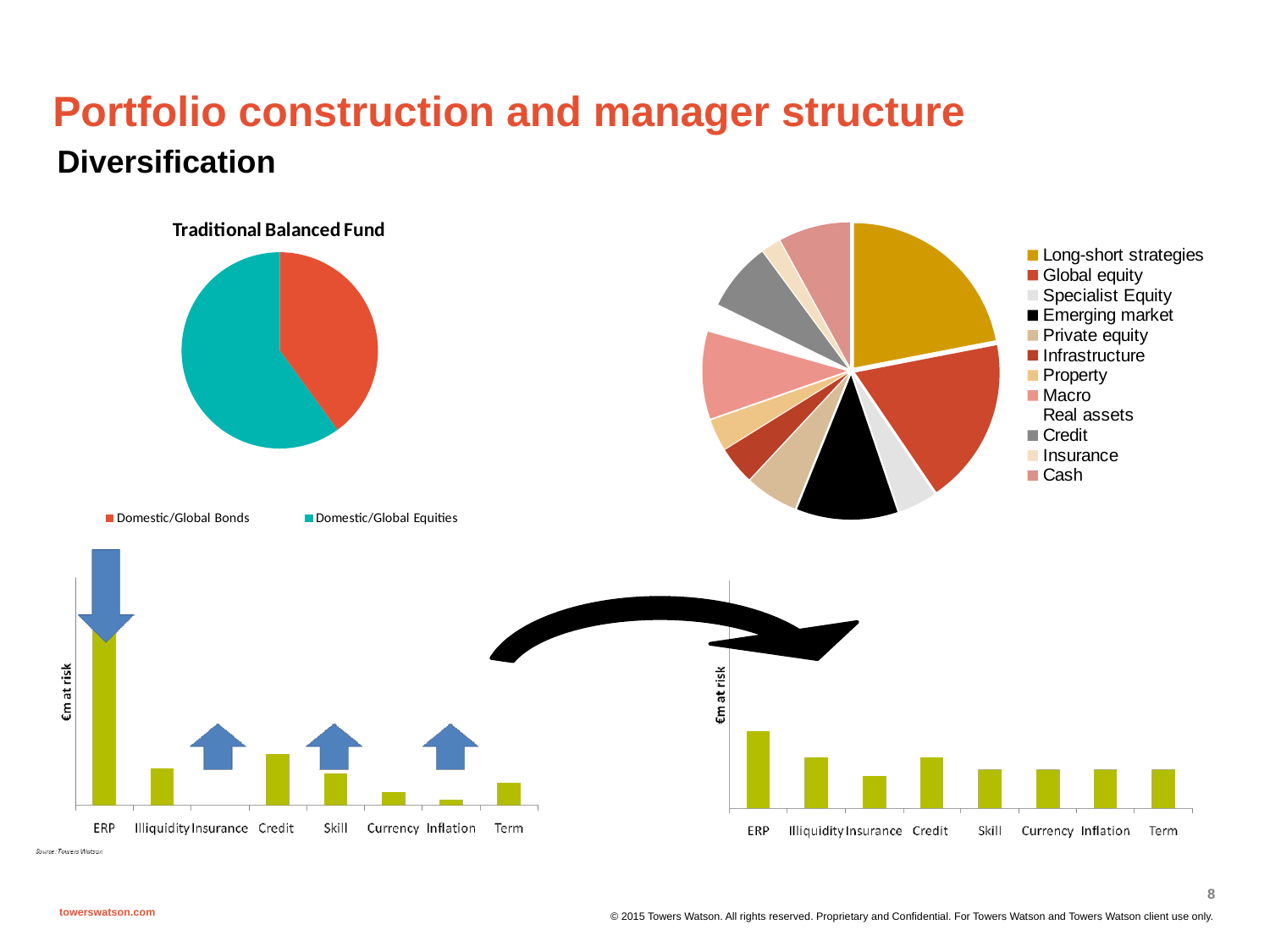
In the 'Traditional Balanced Fund' pie chart, how many entries does the legend list? 2 What kind of chart is the chart at the bottom left of the slide? Bar chart In the bar chart at the bottom left of the slide, which category has the highest value? ERP In the bar chart at the bottom left of the slide, how many categories are shown on the x axis? 8 In the pie chart at the top right of the slide, how many entries does the legend list? 12 What kind of chart is the 'Traditional Balanced Fund' chart at the top left of the slide? Pie chart In the bar chart at the bottom left of the slide, what is the label on the y axis? €m at risk In the pie chart at the top right of the slide, which category has the largest slice? Long-short strategies In the bar chart at the bottom right of the slide, which category has the highest value? ERP In the bar chart at the bottom right of the slide, which category has the lowest value? Insurance In the 'Traditional Balanced Fund' pie chart, which slice is larger, Domestic/Global Bonds or Domestic/Global Equities? Domestic/Global Equities